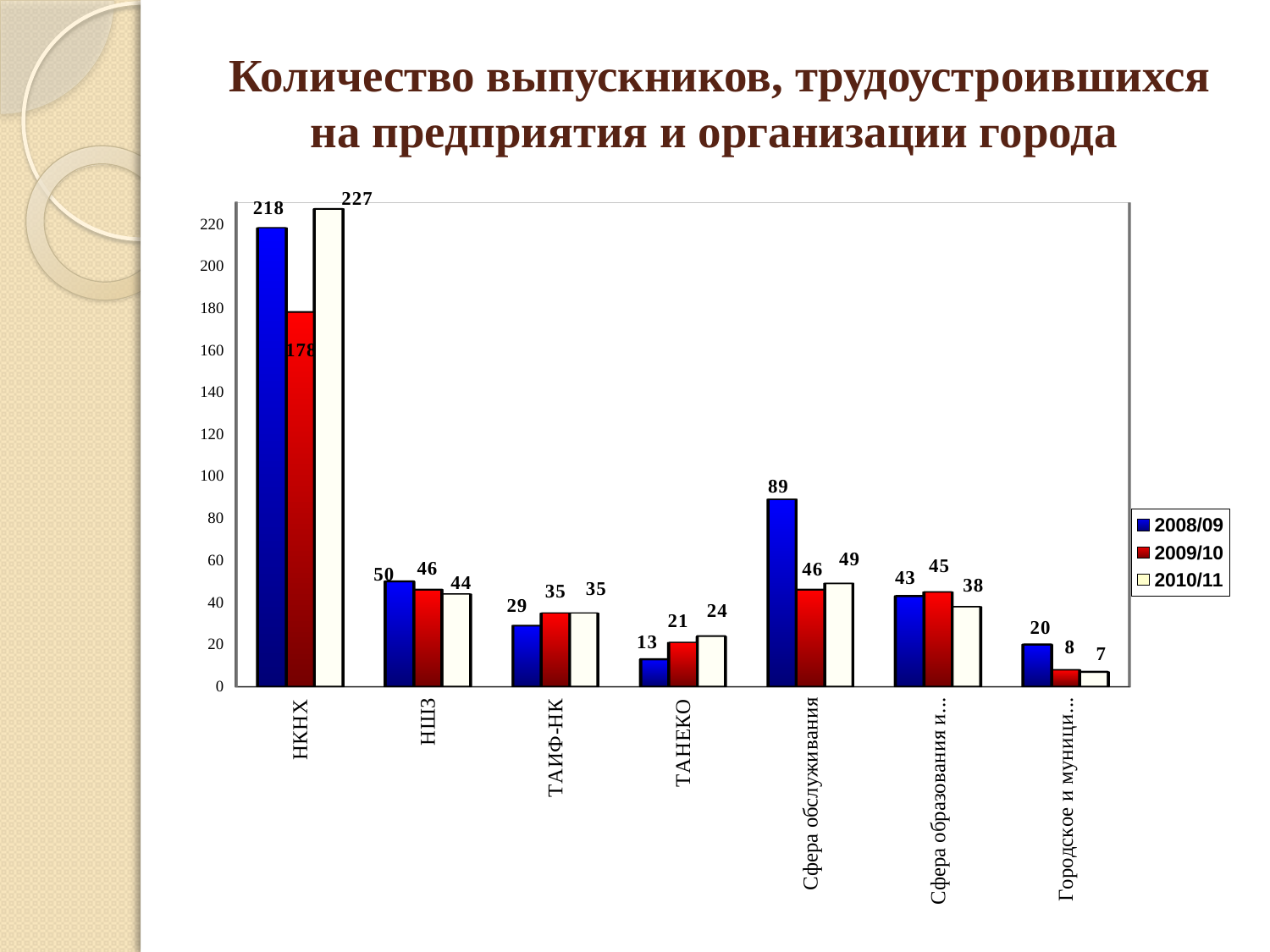
Which is larger for НШЗ: the 2008/09 value or the 2010/11 value? 2008/09 Which series is shown in red in the legend? 2009/10 What is the value for НКНХ in the 2010/11 series? 227 What is the value for Сфера обслуживания in the 2009/10 series? 46 Is the value for Сфера обслуживания in 2008/09 greater or less than 80? greater Which category has the lowest value in the 2010/11 series? Городское и муници... Which category has the highest value in the 2008/09 series? НКНХ How many series does the legend list? 3 What is the value for ТАНЕКО in the 2008/09 series? 13 What type of chart is shown on the slide? bar chart How many categories are shown on the x axis? 7 What is the difference between the 2010/11 and 2009/10 values for НКНХ? 49